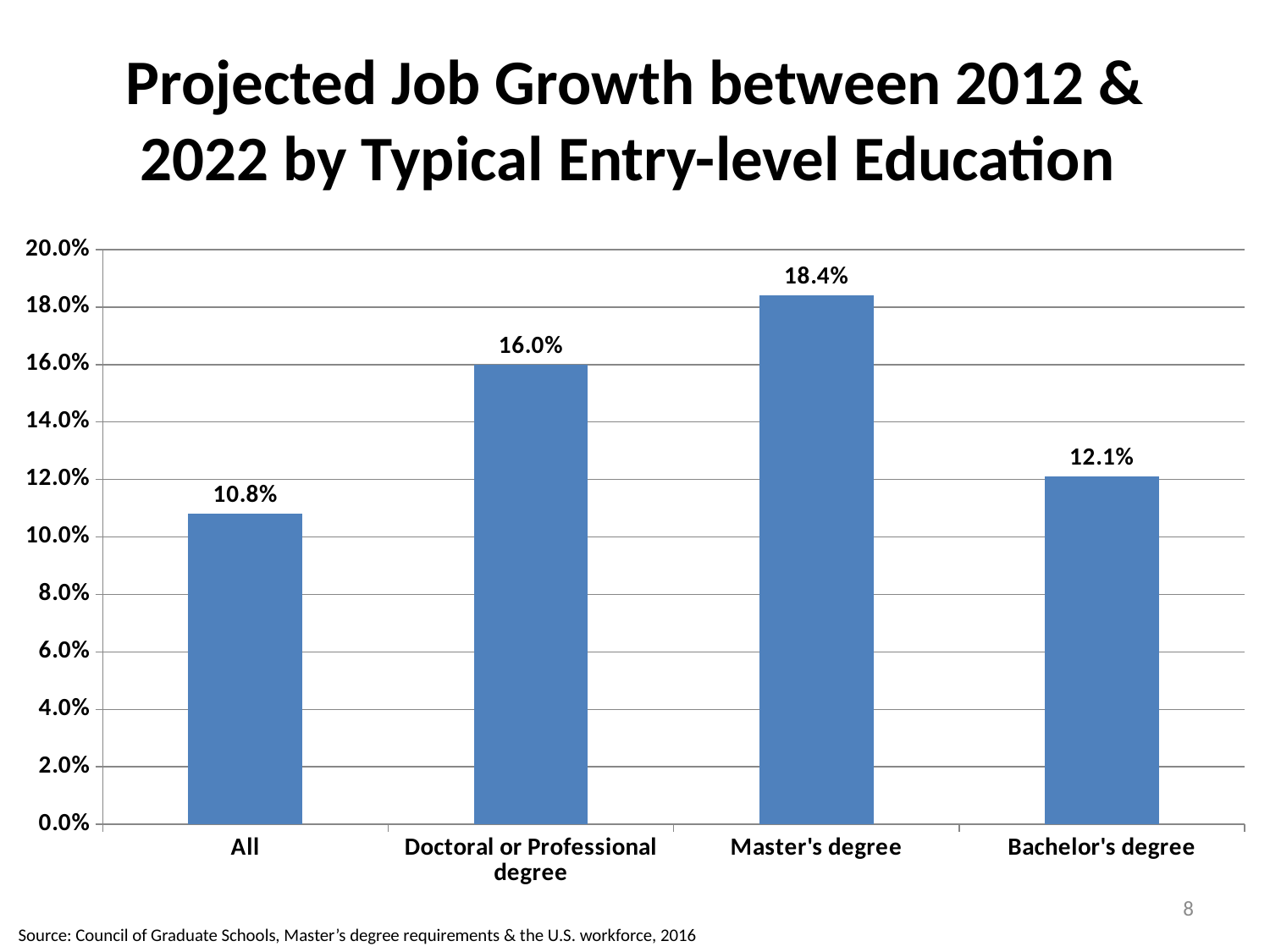
Which category has the lowest projected job growth? All What is the projected job growth for Doctoral or Professional degree? 16.0% What is the difference in projected job growth between Doctoral or Professional degree and All? 5.2% How many categories are shown on the chart? 4 What is the projected job growth for Bachelor's degree? 12.1% Is the value for Bachelor's degree greater or less than 14.0%? less Which category has the highest projected job growth? Master's degree What is the difference in projected job growth between Master's degree and Bachelor's degree? 6.3% What is the projected job growth for Master's degree? 18.4% What kind of chart is shown on the slide? Bar chart Which has higher projected job growth, Doctoral or Professional degree or Bachelor's degree? Doctoral or Professional degree What is the projected job growth for All? 10.8%